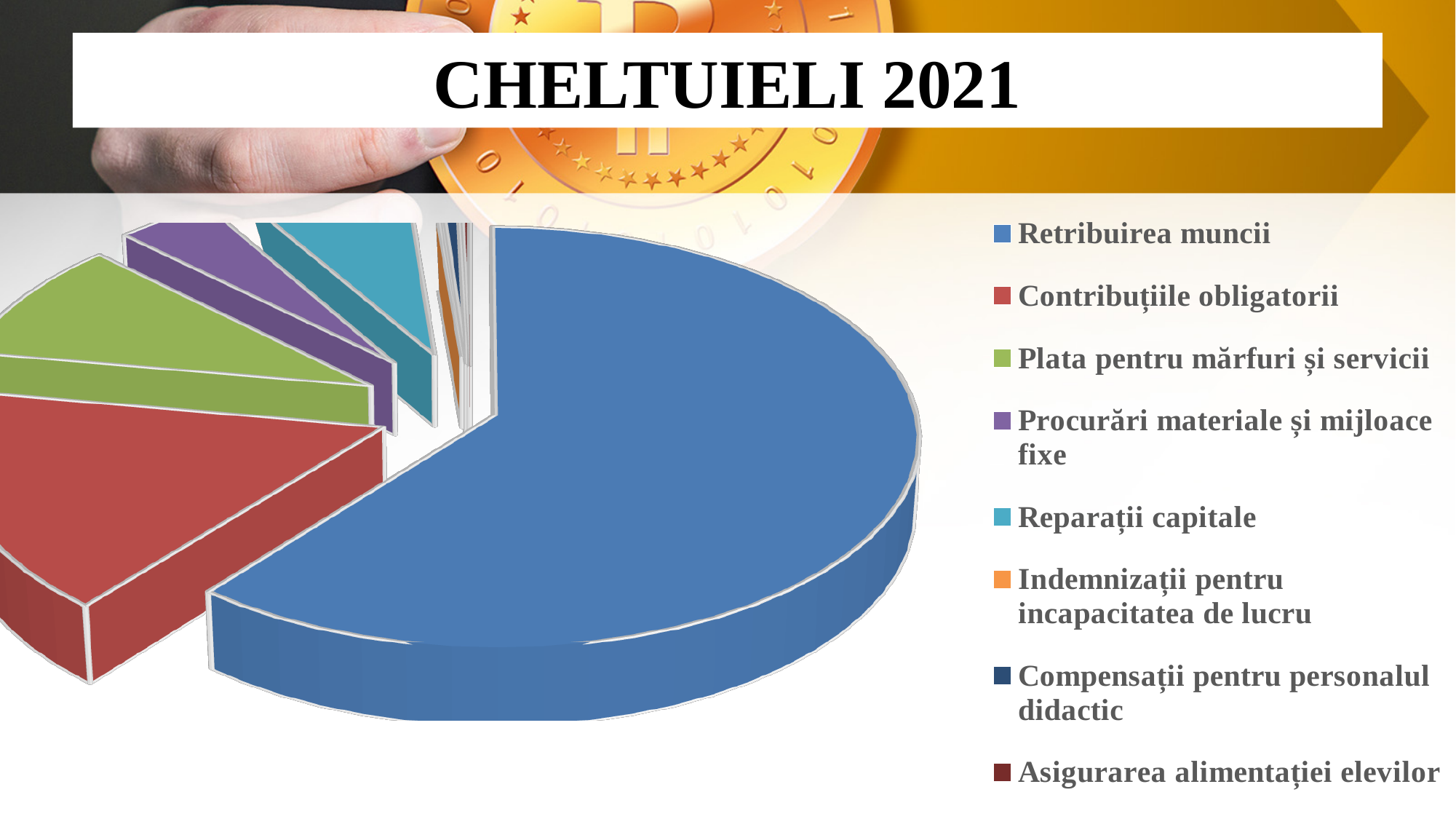
Which slice is larger: Contribuțiile obligatorii or Plata pentru mărfuri și servicii? Contribuțiile obligatorii What is the title of the chart on the slide? CHELTUIELI 2021 How many categories does the legend of the pie chart list? 8 Which category is shown in red in the pie chart? Contribuțiile obligatorii What colour is the slice for Retribuirea muncii in the pie chart? blue Which slice is larger: Plata pentru mărfuri și servicii or Procurări materiale și mijloace fixe? Plata pentru mărfuri și servicii Which category has the largest slice of the pie chart? Retribuirea muncii Which slice is larger: Reparații capitale or Indemnizații pentru incapacitatea de lucru? Reparații capitale What kind of chart is shown on the slide? pie chart